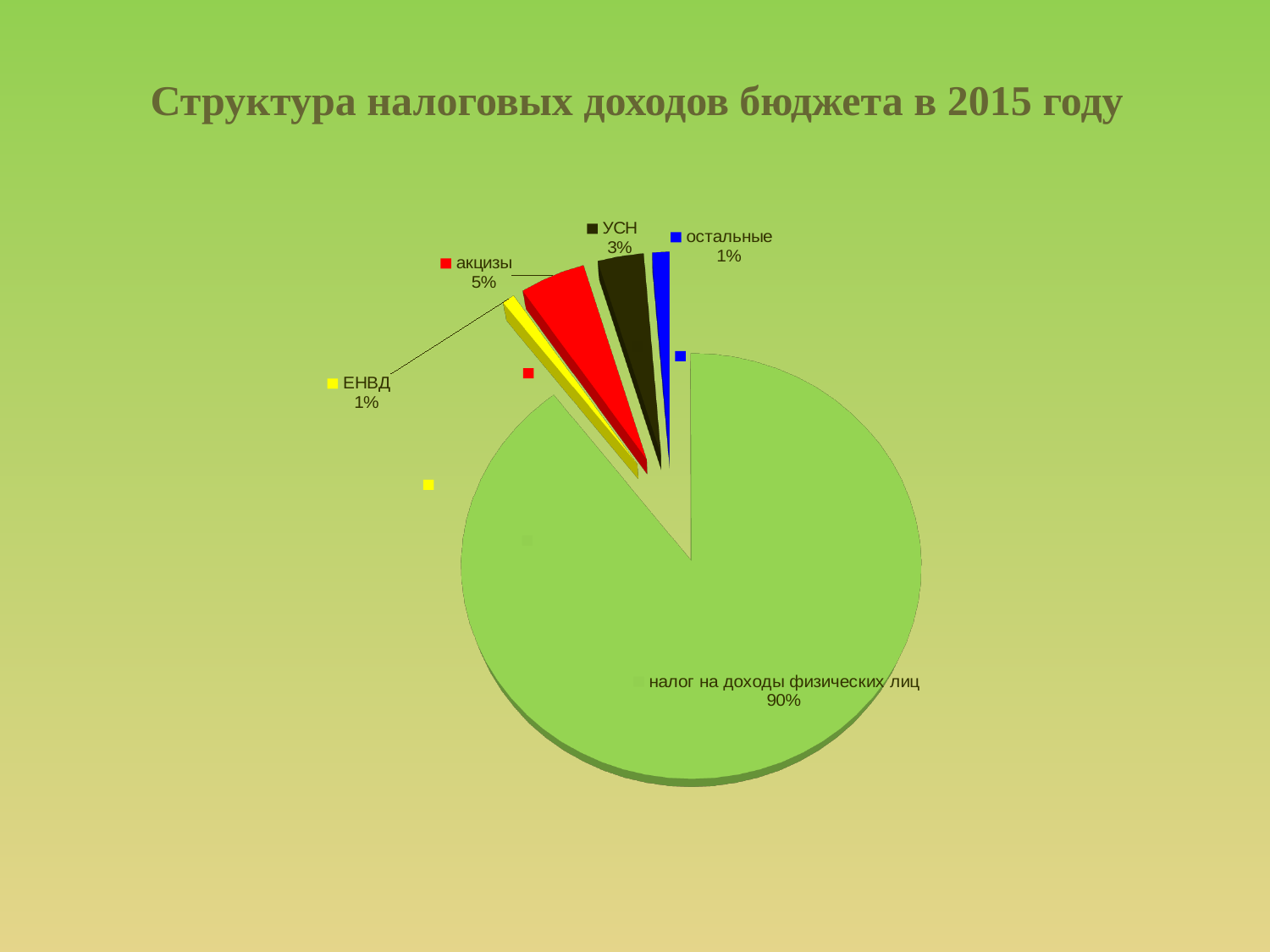
What is the difference between the share for акцизы and the share for УСН? 2% What share of the pie does ЕНВД represent? 1% Which is larger, the share for акцизы or the share for УСН? акцизы What kind of chart is shown on the slide? pie chart What is the title of the chart? Структура налоговых доходов бюджета в 2015 году What share of the pie does налог на доходы физических лиц represent? 90% What share of the pie does остальные represent? 1% Which category has the largest share of the pie? налог на доходы физических лиц What is the difference between the share for налог на доходы физических лиц and the share for акцизы? 85% How many categories are shown in the pie chart? 5